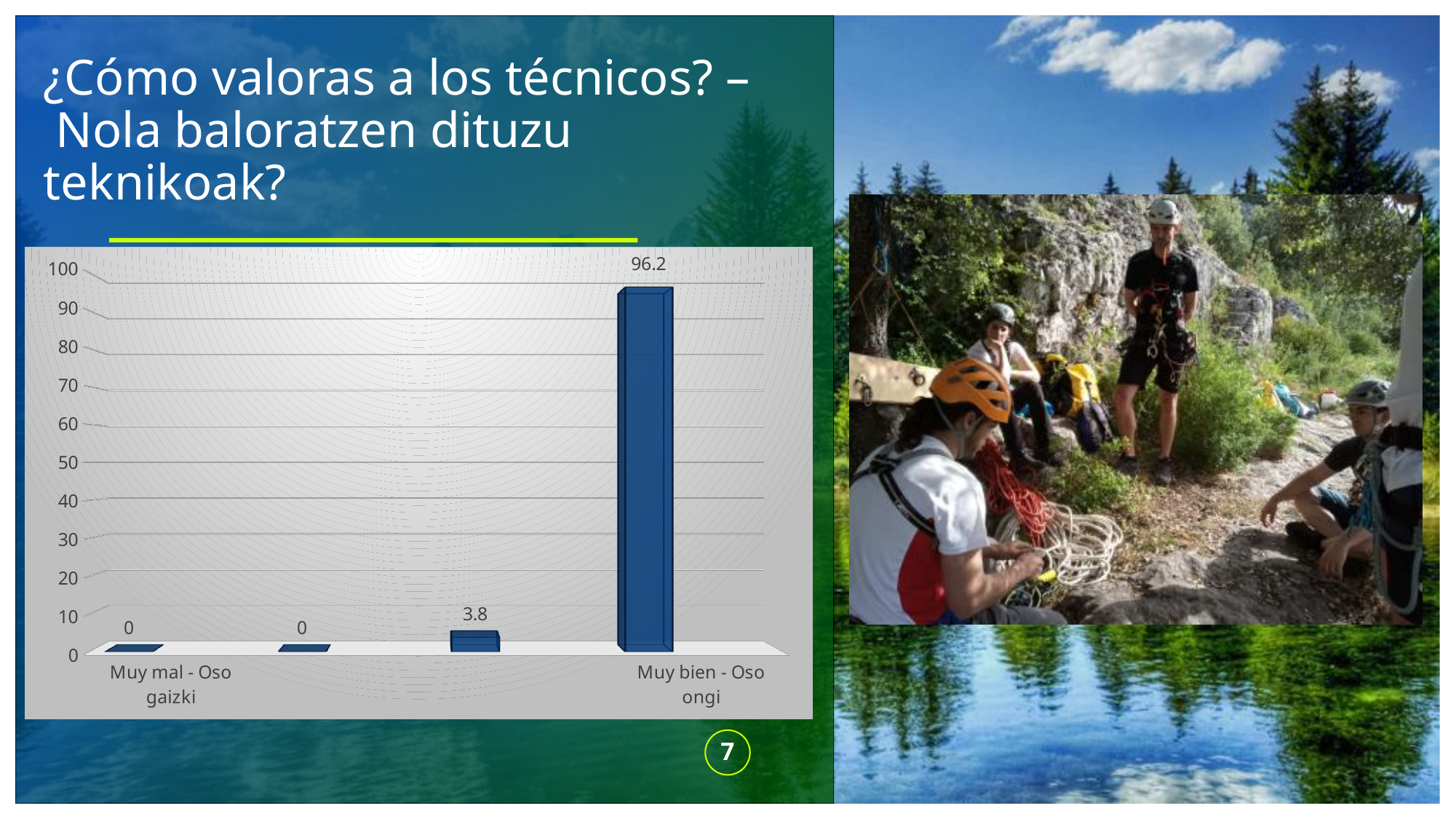
Which category has the highest value? Muy bien - Oso ongi What is the value for "Muy mal - Oso gaizki"? 0 What is the value shown on the third bar from the left? 3.8 How many bars are plotted in the chart? 4 Do the values rise or fall from left to right across the categories? Rise Which is larger, the value for "Muy bien - Oso ongi" or the value for "Muy mal - Oso gaizki"? Muy bien - Oso ongi Is the value for "Muy bien - Oso ongi" greater or less than 90? greater What is the difference between the value for "Muy bien - Oso ongi" and the value for "Muy mal - Oso gaizki"? 96.2 What is the difference between the value for "Muy bien - Oso ongi" and the value of the third bar from the left? 92.4 What is the value for "Muy bien - Oso ongi"? 96.2 What is the highest value shown on the vertical axis? 100 What kind of chart is shown on the slide? Bar chart